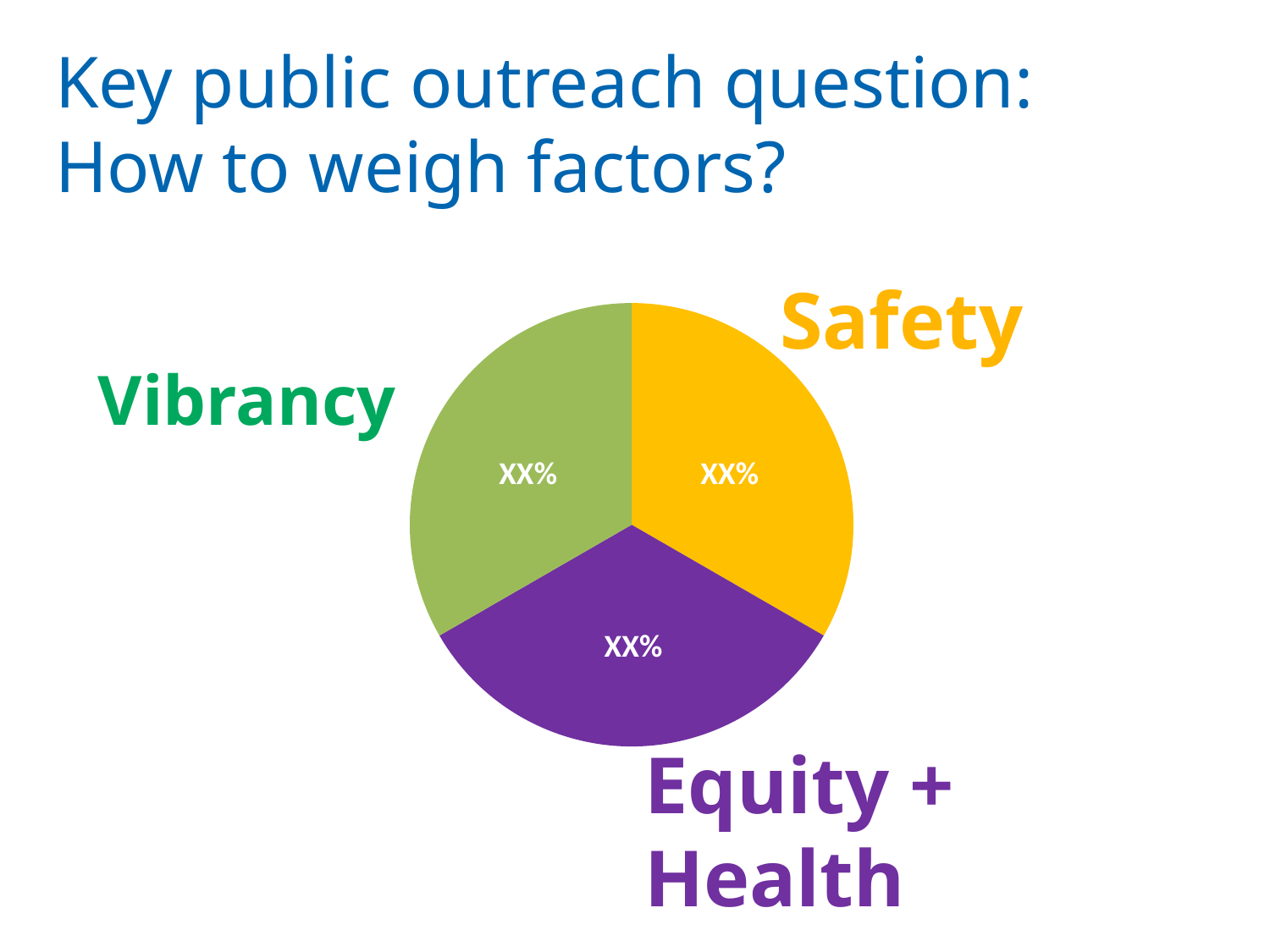
What value label is printed on the Safety slice of the pie chart? XX% What value label is printed on the Equity + Health slice of the pie chart? XX% How many slices does the pie chart have? 3 Which category is represented by the purple slice of the pie chart? Equity + Health What kind of chart is shown on the slide? pie chart What value label is printed on the Vibrancy slice of the pie chart? XX% What colour is the Safety slice of the pie chart? yellow